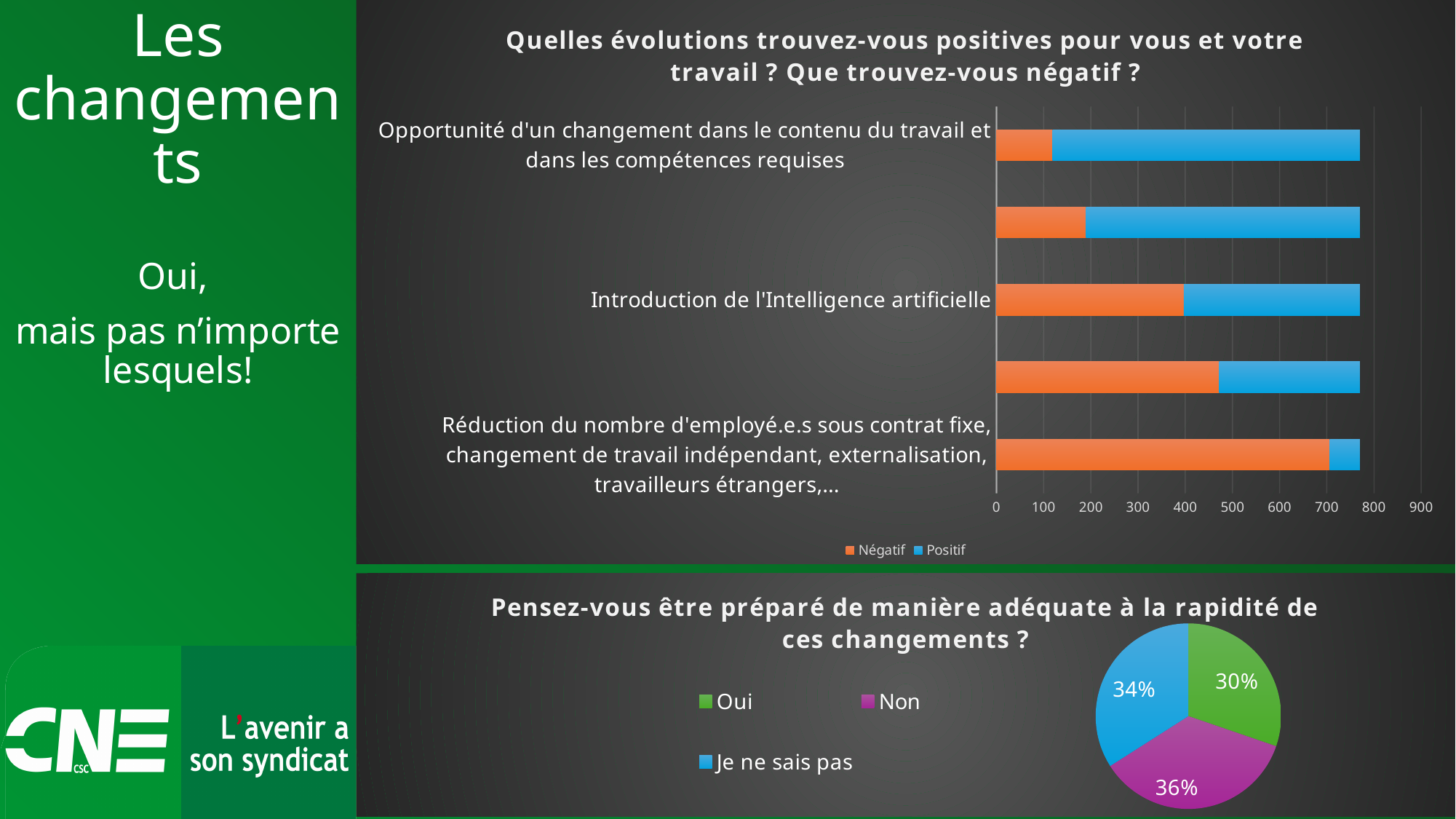
In the top chart, how many bars are plotted? 5 In the top chart, which of the labelled categories has the smallest Négatif value? Opportunité d'un changement dans le contenu du travail et dans les compétences requises In the top chart, which of the labelled categories has the largest Négatif value? Réduction du nombre d'employé.e.s sous contrat fixe, changement de travail indépendant, externalisation, travailleurs étrangers,… In the top chart, what kind of chart is used? bar chart In the top chart, is the Négatif value for 'Introduction de l'Intelligence artificielle' greater or less than 300? greater In the bottom pie chart, which answer has the smallest share? Oui In the top chart, which series is shown in orange? Négatif In the top chart, how many series does the legend list? 2 In the top chart, is the Négatif value for 'Réduction du nombre d'employé.e.s sous contrat fixe, changement de travail indépendant, externalisation, travailleurs étrangers,…' greater or less than 600? greater In the bottom pie chart, what is the difference between the 'Non' share and the 'Oui' share? 6% In the bottom pie chart, what share of respondents answered 'Non'? 36% In the top chart, is the Négatif value for 'Opportunité d'un changement dans le contenu du travail et dans les compétences requises' greater or less than 200? less